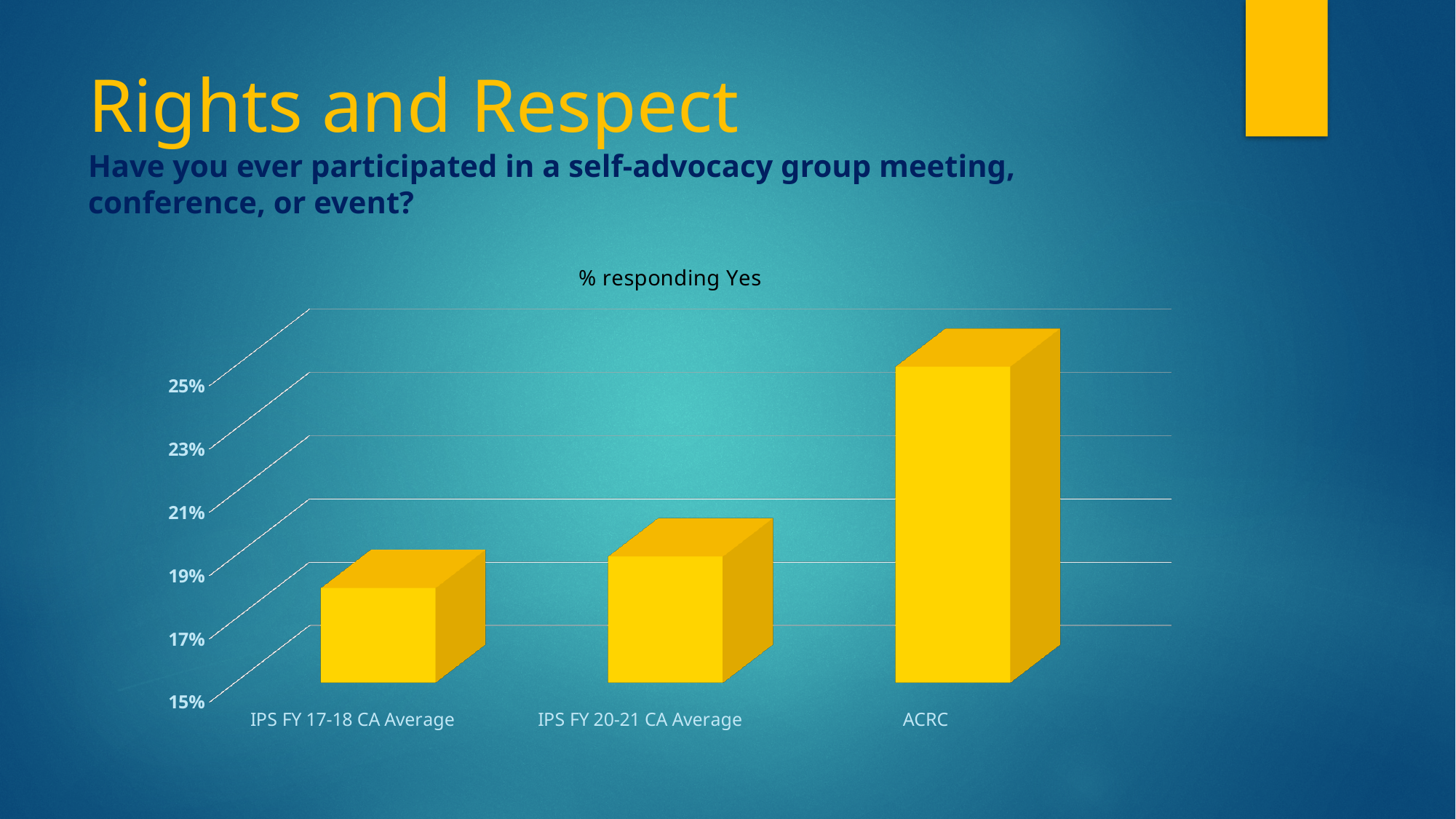
What colour are the bars in the chart? yellow Which category has the lowest value in the chart? IPS FY 17-18 CA Average Do the values rise or fall moving from left to right along the x axis? rise What is the title of the chart? % responding Yes Which is larger, the value for ACRC or the value for IPS FY 20-21 CA Average? ACRC What kind of chart is shown on the slide? bar chart Which category has the highest value in the chart? ACRC Is the value for IPS FY 20-21 CA Average greater or less than 21%? less Is the value for ACRC greater or less than 23%? greater Is the value for IPS FY 17-18 CA Average greater or less than 19%? less How many categories are plotted in the chart? 3